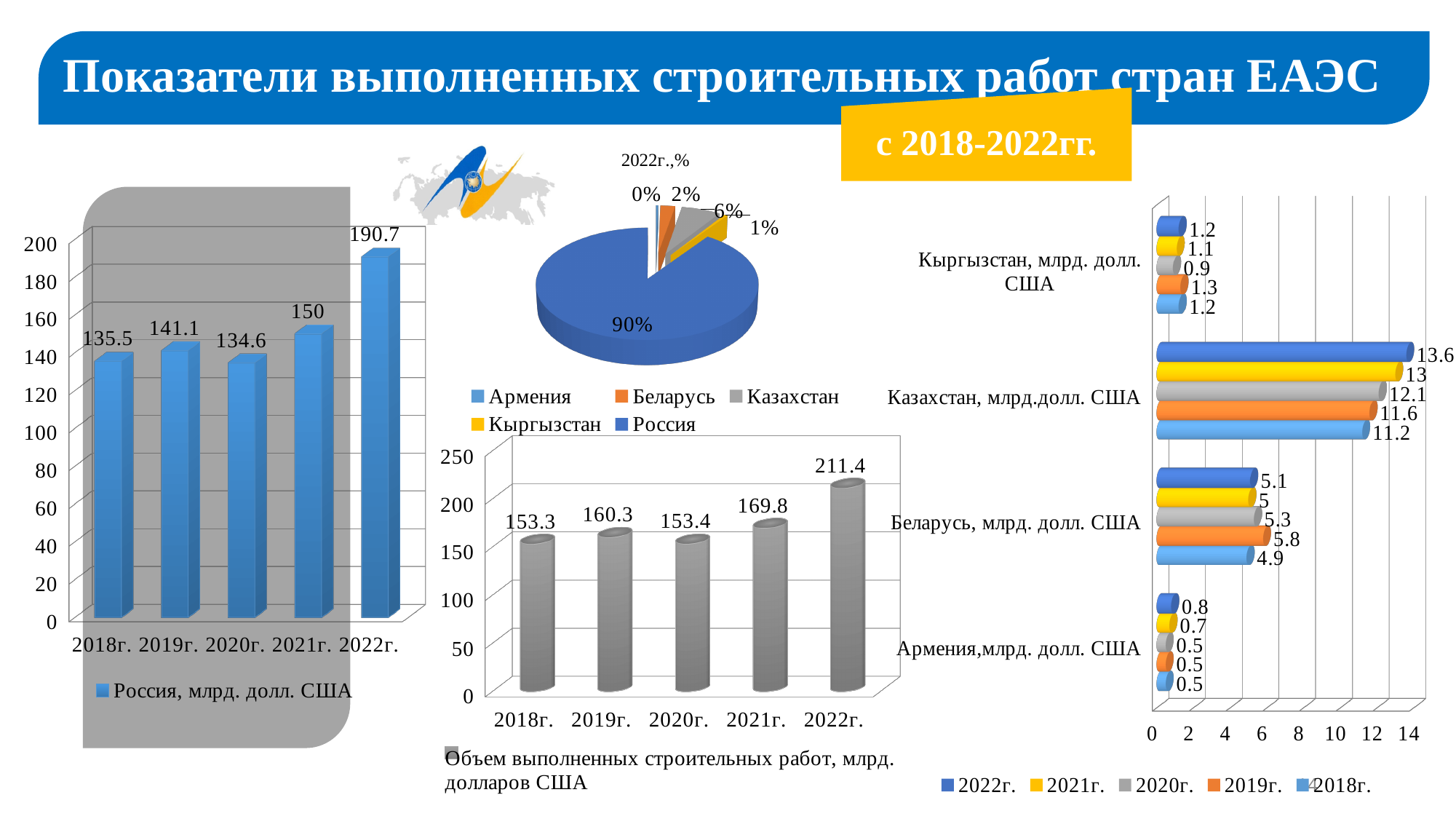
In the right horizontal bar chart, what is the value for Казахстан in 2022г.? 13.6 In the right horizontal bar chart, which year has the highest value for Беларусь? 2019г. In the middle bar chart 'Объем выполненных строительных работ, млрд. долларов США', which year has the highest value? 2022г. In the left bar chart for Russia, what is the value for 2022г.? 190.7 In the pie chart titled '2022г.,%', what share does Казахстан have? 6% In the left bar chart for Russia, which year has the lowest value? 2020г. In the middle bar chart 'Объем выполненных строительных работ, млрд. долларов США', what is the value for 2019г.? 160.3 In the middle bar chart 'Объем выполненных строительных работ, млрд. долларов США', is the value for 2021г. greater or less than 150? greater In the pie chart titled '2022г.,%', what share does Россия have? 90% How many categories does the legend of the pie chart titled '2022г.,%' list? 5 How many series does the legend of the right horizontal bar chart list? 5 In the left bar chart for Russia, what is the difference between the 2022г. and 2021г. values? 40.7